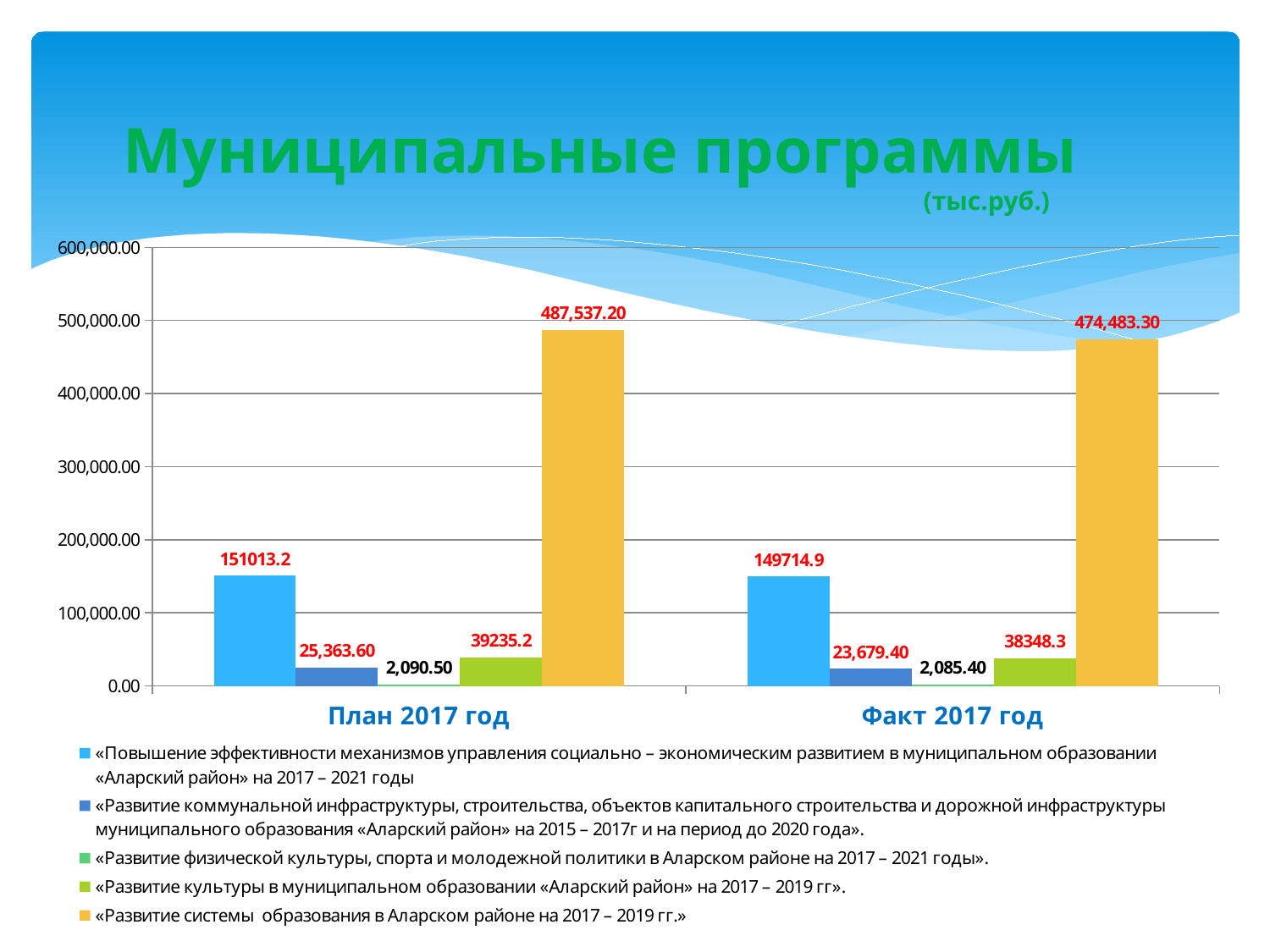
What unit is given under the chart title? тыс.руб. What is the value for «Развитие системы образования в Аларском районе на 2017 – 2019 гг.» in Факт 2017 год? 474,483.30 What type of chart is shown on the slide? bar chart What is the difference between the План 2017 год and Факт 2017 год values for «Развитие системы образования в Аларском районе на 2017 – 2019 гг.»? 13,053.90 How many categories are shown on the x axis? 2 How many series does the legend list? 5 Which series has the highest value in План 2017 год? «Развитие системы образования в Аларском районе на 2017 – 2019 гг.» Which is larger: the value for «Развитие коммунальной инфраструктуры...» in План 2017 год or in Факт 2017 год? План 2017 год What is the value for «Развитие системы образования в Аларском районе на 2017 – 2019 гг.» in План 2017 год? 487,537.20 What is the value for «Повышение эффективности механизмов управления социально – экономическим развитием...» in Факт 2017 год? 149714.9 Which series has the lowest value in Факт 2017 год? «Развитие физической культуры, спорта и молодежной политики в Аларском районе на 2017 – 2021 годы» What is the value for «Развитие культуры в муниципальном образовании «Аларский район» на 2017 – 2019 гг.» in План 2017 год? 39235.2